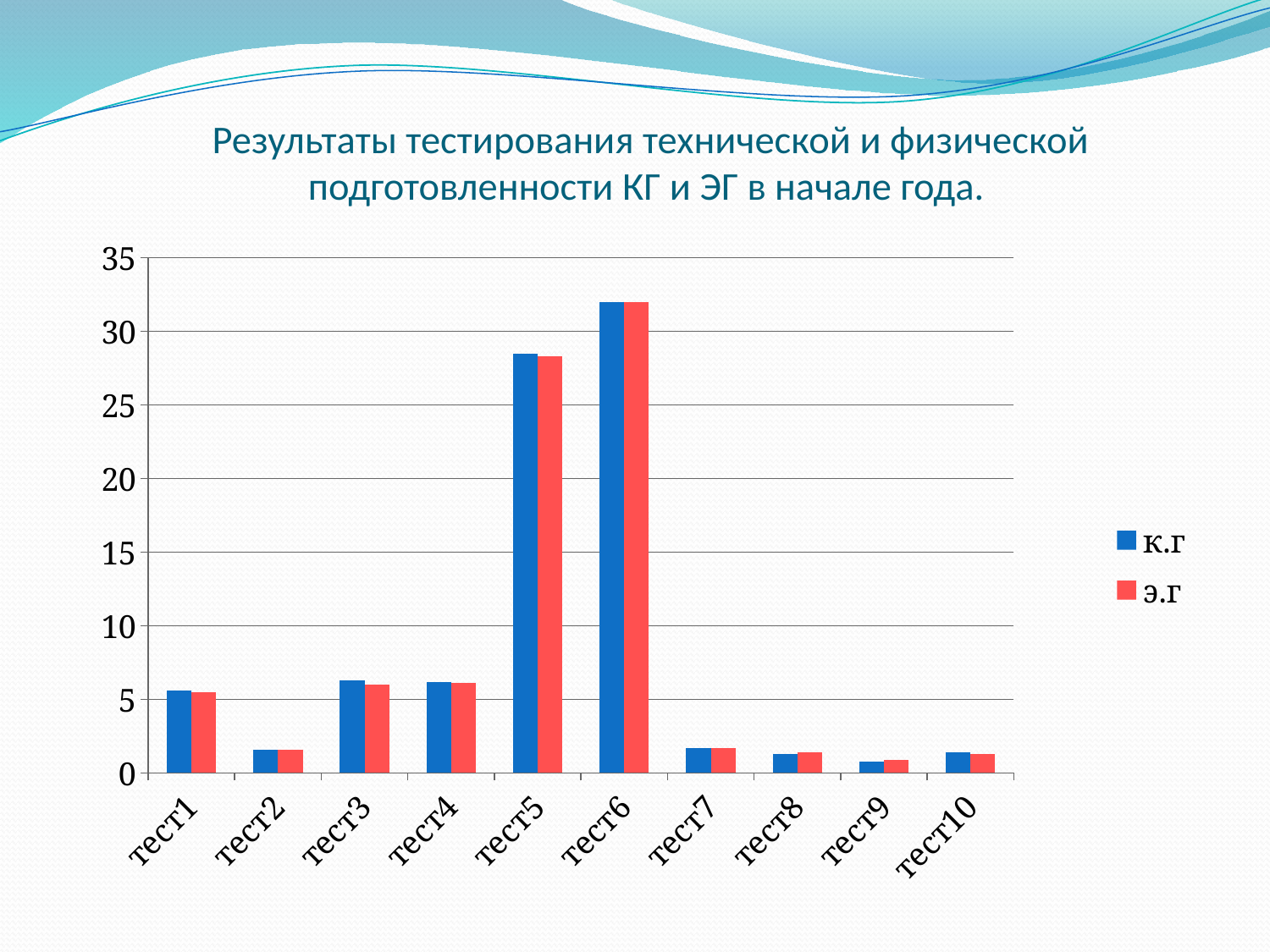
Which test has the lowest value for the э.г series? тест9 How many test categories are shown on the x axis? 10 What kind of chart is shown on the slide? bar chart Is the к.г value for тест5 greater or less than 25? greater Which is larger for the к.г series: тест5 or тест6? тест6 Is the к.г value for тест2 greater or less than 5? less Which is larger for the э.г series: тест1 or тест7? тест1 Is the э.г value for тест3 greater or less than 5? greater How many series does the legend list? 2 Which test has the highest value for the к.г series? тест6 Which colour represents the э.г series in the legend? red